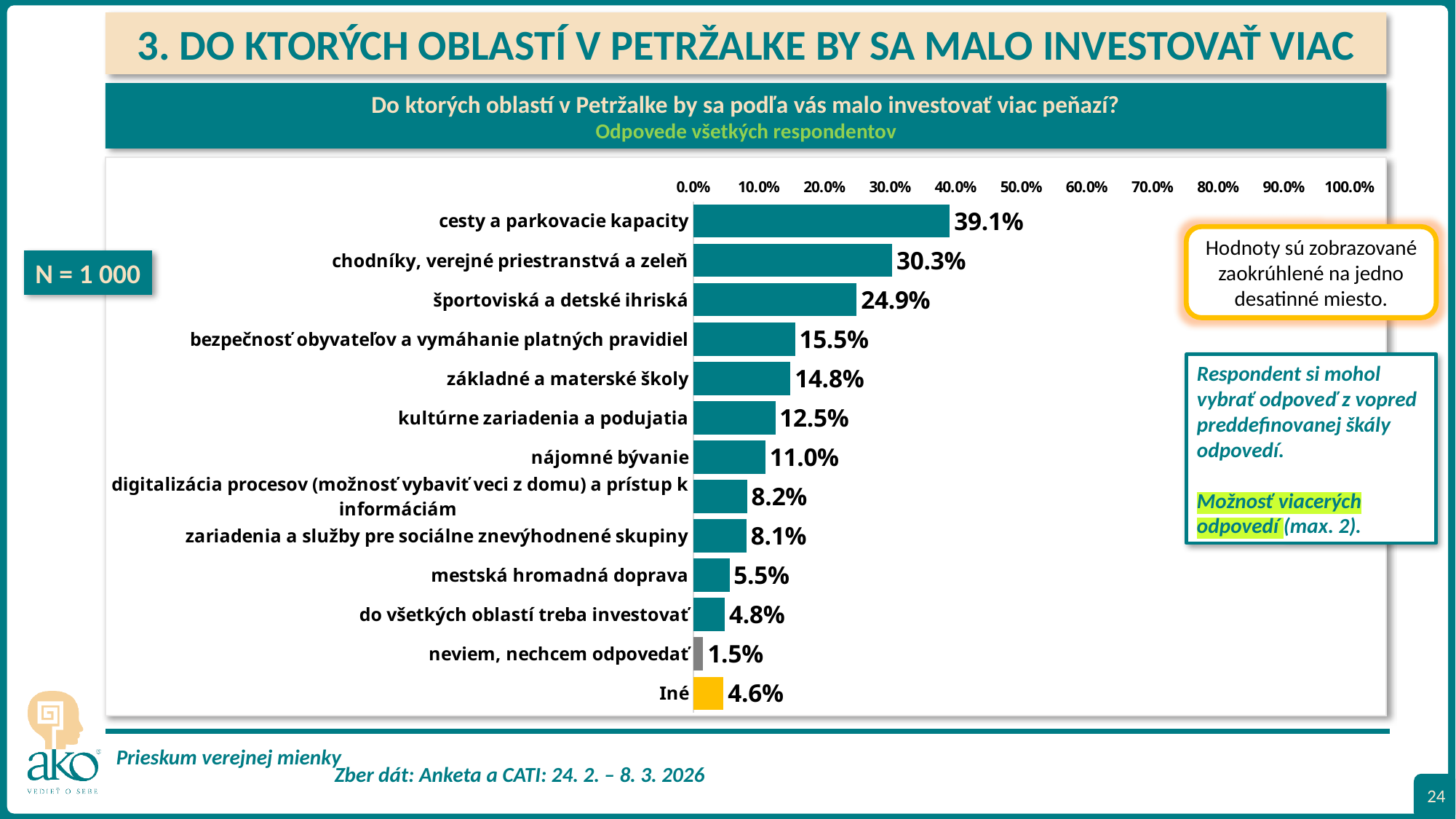
What is the difference between "cesty a parkovacie kapacity" and "chodníky, verejné priestranstvá a zeleň"? 8.8% What is the value for "nájomné bývanie"? 11.0% Is the value for "športoviská a detské ihriská" greater or less than 20.0%? greater Which category has the highest value? cesty a parkovacie kapacity What is the value for "Iné"? 4.6% What kind of chart is shown on the slide? bar chart How many categories are shown in the chart? 13 Which category has the lowest value? neviem, nechcem odpovedať Which is larger: "základné a materské školy" or "kultúrne zariadenia a podujatia"? základné a materské školy What is the value for "cesty a parkovacie kapacity"? 39.1% What colour is the bar for "Iné"? yellow What is the difference between "mestská hromadná doprava" and "do všetkých oblastí treba investovať"? 0.7%